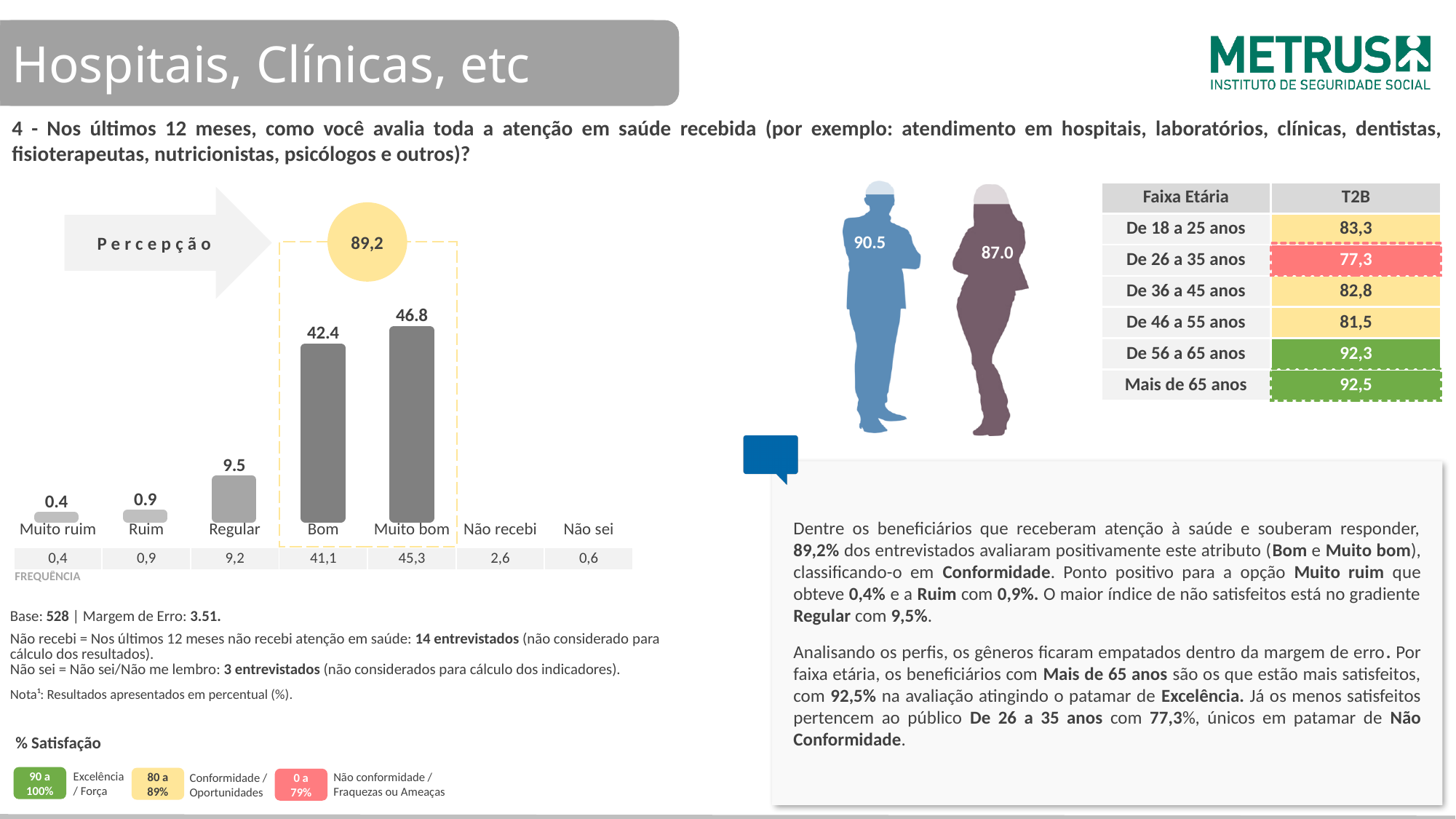
What is the difference between the values for Bom and Regular? 32.9 What is the value of the bar for Regular? 9.5 What is the value of the bar for Muito bom? 46.8 Do the bar values rise or fall from Muito ruim to Muito bom along the x axis? Rise Which category has the highest bar in the chart? Muito bom What is the value of the bar for Bom? 42.4 What is the value of the bar for Muito ruim? 0.4 How many bars are plotted in the chart? 5 What is the difference between the values for Muito bom and Bom? 4.4 What kind of chart is shown on the slide? Bar chart Which is larger, the value for Ruim or the value for Muito ruim? Ruim Which category has the lowest bar in the chart? Muito ruim